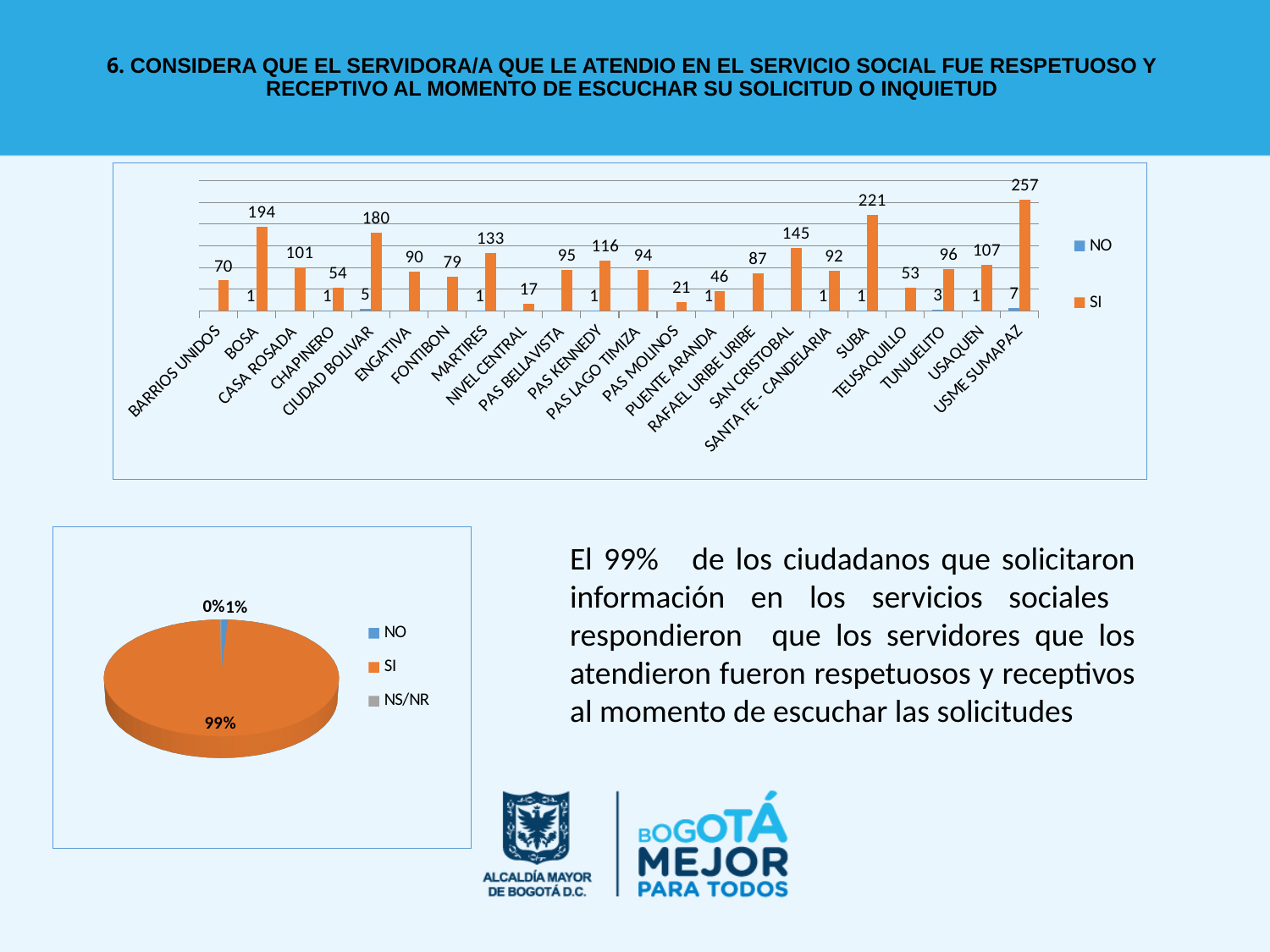
In the bar chart, what is the SI value for USME SUMAPAZ? 257 How many categories are shown on the x axis of the bar chart? 22 In the bar chart, what is the NO value for CIUDAD BOLIVAR? 5 In the bar chart, which category has the highest SI value? USME SUMAPAZ In the bar chart, which has a larger SI value, ENGATIVA or FONTIBON? ENGATIVA How many series does the legend of the bar chart list? 2 How many slices does the legend of the pie chart list? 3 In the bar chart, what is the SI value for BOSA? 194 In the pie chart, what share does SI have? 99% What type of chart is the chart at the top of the slide? bar chart In the bar chart, what is the difference between the SI values for SUBA and SAN CRISTOBAL? 76 In the bar chart, which category has the lowest SI value? NIVEL CENTRAL